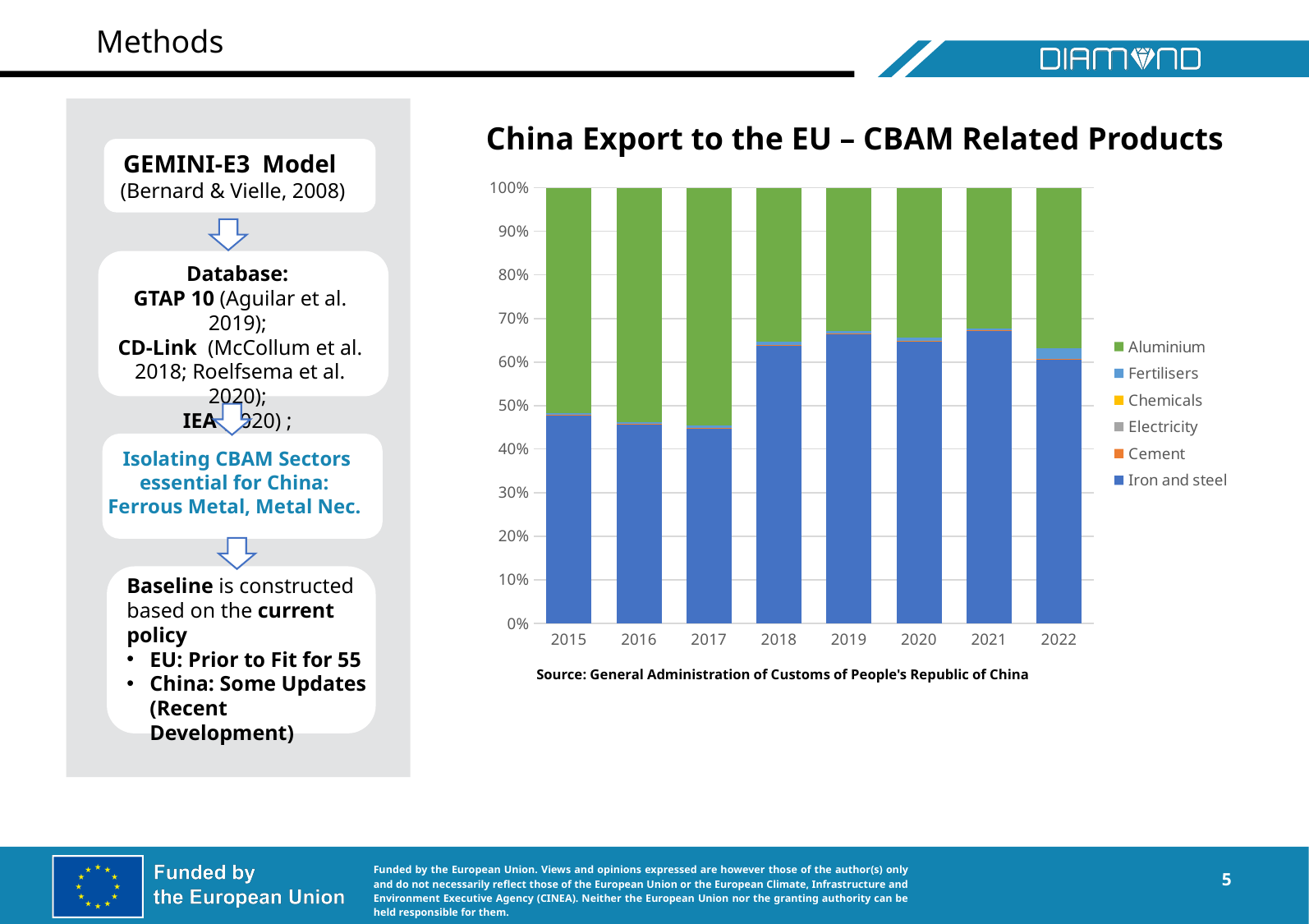
What is the total height of each stacked bar in the chart? 100% What kind of chart is shown on the slide? Stacked bar chart Which year has the larger Aluminium share, 2015 or 2021? 2015 How many series does the chart legend list? 6 Is the Iron and steel share in 2015 greater or less than 50%? less Is the Iron and steel share in 2021 greater or less than 60%? greater How many years are shown on the x axis of the chart? 8 Is the Iron and steel share in 2018 greater or less than 60%? greater What is the title of the chart? China Export to the EU – CBAM Related Products Which year has the larger Iron and steel share, 2017 or 2018? 2018 Which series is shown in green in the chart? Aluminium